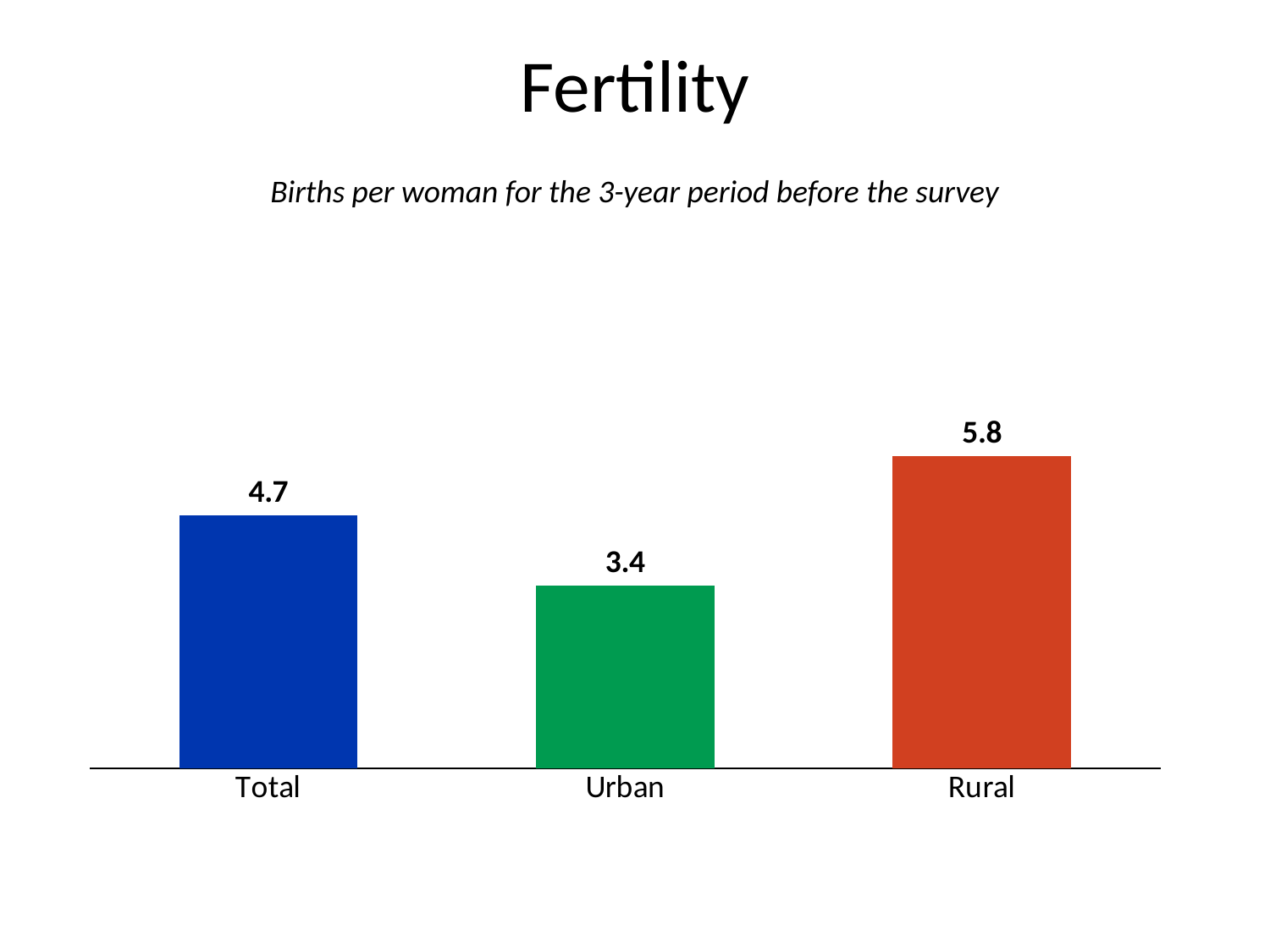
What is the value for Total? 4.7 What kind of chart is shown on the slide? Bar chart What is the value for Rural? 5.8 How many categories are shown on the chart? 3 Which is larger, the value for Urban or the value for Total? Total What is the value for Urban? 3.4 What colour is the bar for Rural? Red What is the title of the slide? Fertility What is the difference between the Rural and Total values? 1.1 Which category has the lowest value? Urban Which category has the highest value? Rural What is the difference between the Rural and Urban values? 2.4